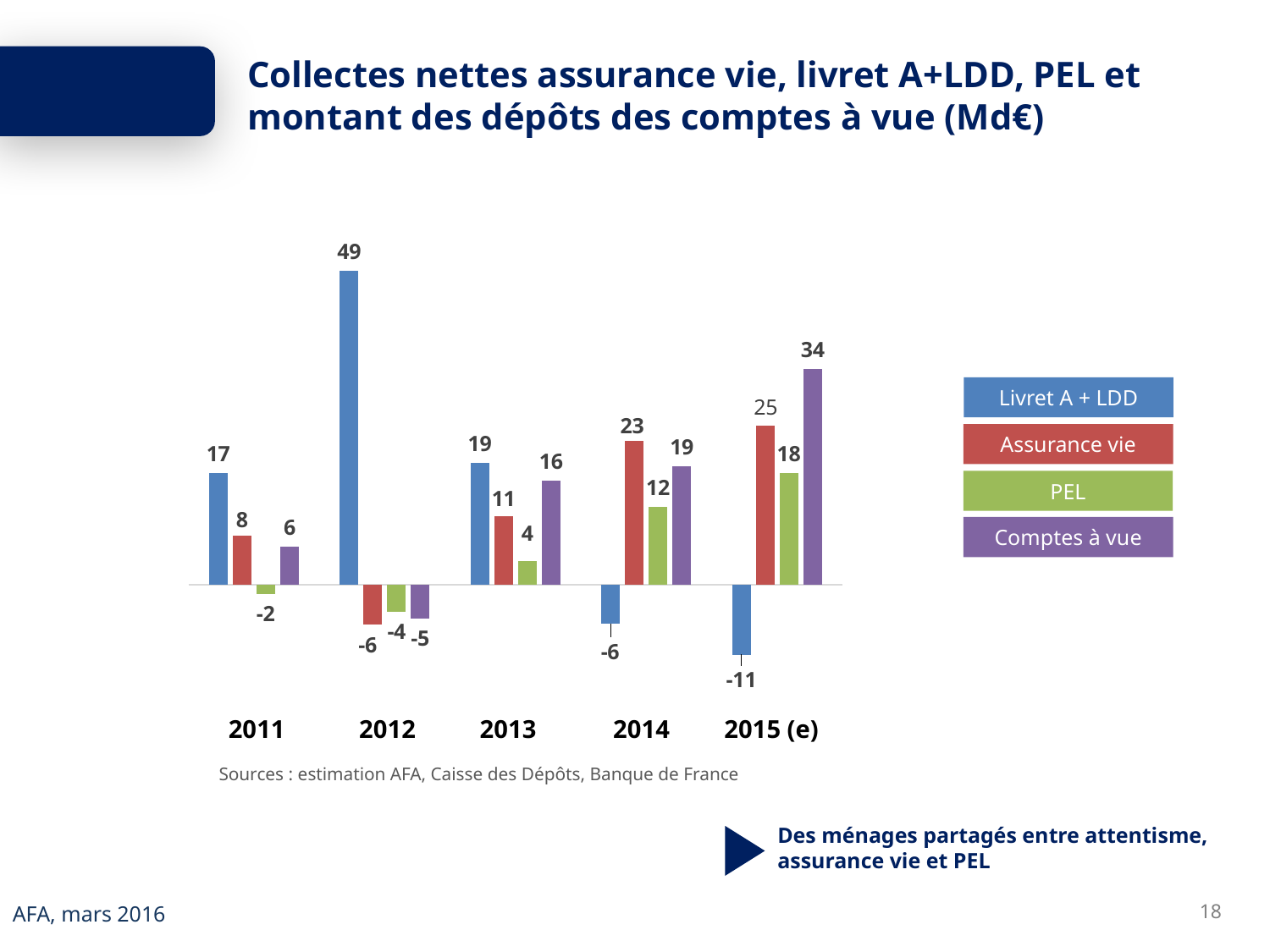
How many years are shown on the x axis? 5 What is the value for Livret A + LDD in 2015 (e)? -11 What is the difference between the Assurance vie value in 2015 (e) and in 2011? 17 How many series does the legend list? 4 Which is larger in 2013: Assurance vie or Comptes à vue? Comptes à vue What is the value for Assurance vie in 2014? 23 In which year is the Livret A + LDD value lowest? 2015 (e) What kind of chart is shown on the slide? Bar chart What is the value for PEL in 2013? 4 In which year is the Livret A + LDD value highest? 2012 What is the value for Livret A + LDD in 2012? 49 What is the value for Comptes à vue in 2015 (e)? 34